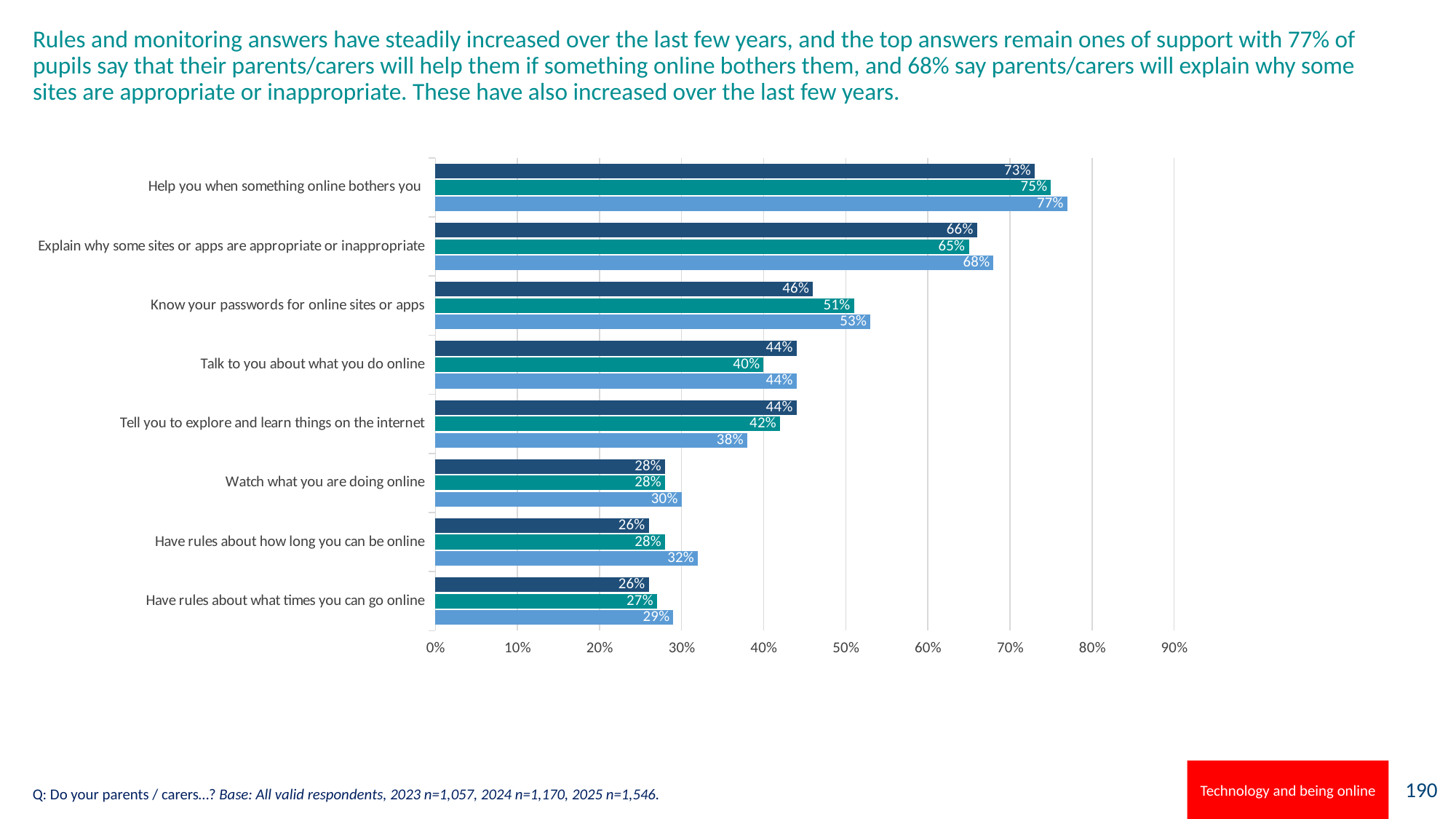
Which category has the highest value among the light blue (bottom) bars? Help you when something online bothers you Is the value of the teal (middle) bar for 'Explain why some sites or apps are appropriate or inappropriate' greater or less than 60%? greater What is the difference between the light blue (bottom) bar and the dark blue (top) bar for 'Know your passwords for online sites or apps'? 7 percentage points What is the value of the light blue (bottom) bar for 'Help you when something online bothers you'? 77% What type of chart is shown on the slide? bar chart What is the value of the dark blue (top) bar for 'Know your passwords for online sites or apps'? 46% Which category has the lowest value among the dark blue (top) bars? Have rules about how long you can be online and Have rules about what times you can go online (both 26%) How many bars are shown for each category in the chart? 3 How many categories are listed on the vertical axis of the chart? 8 For 'Tell you to explore and learn things on the internet', which is larger: the dark blue (top) bar or the light blue (bottom) bar? the dark blue (top) bar What is the value of the teal (middle) bar for 'Talk to you about what you do online'? 40% What is the value of the light blue (bottom) bar for 'Have rules about how long you can be online'? 32%